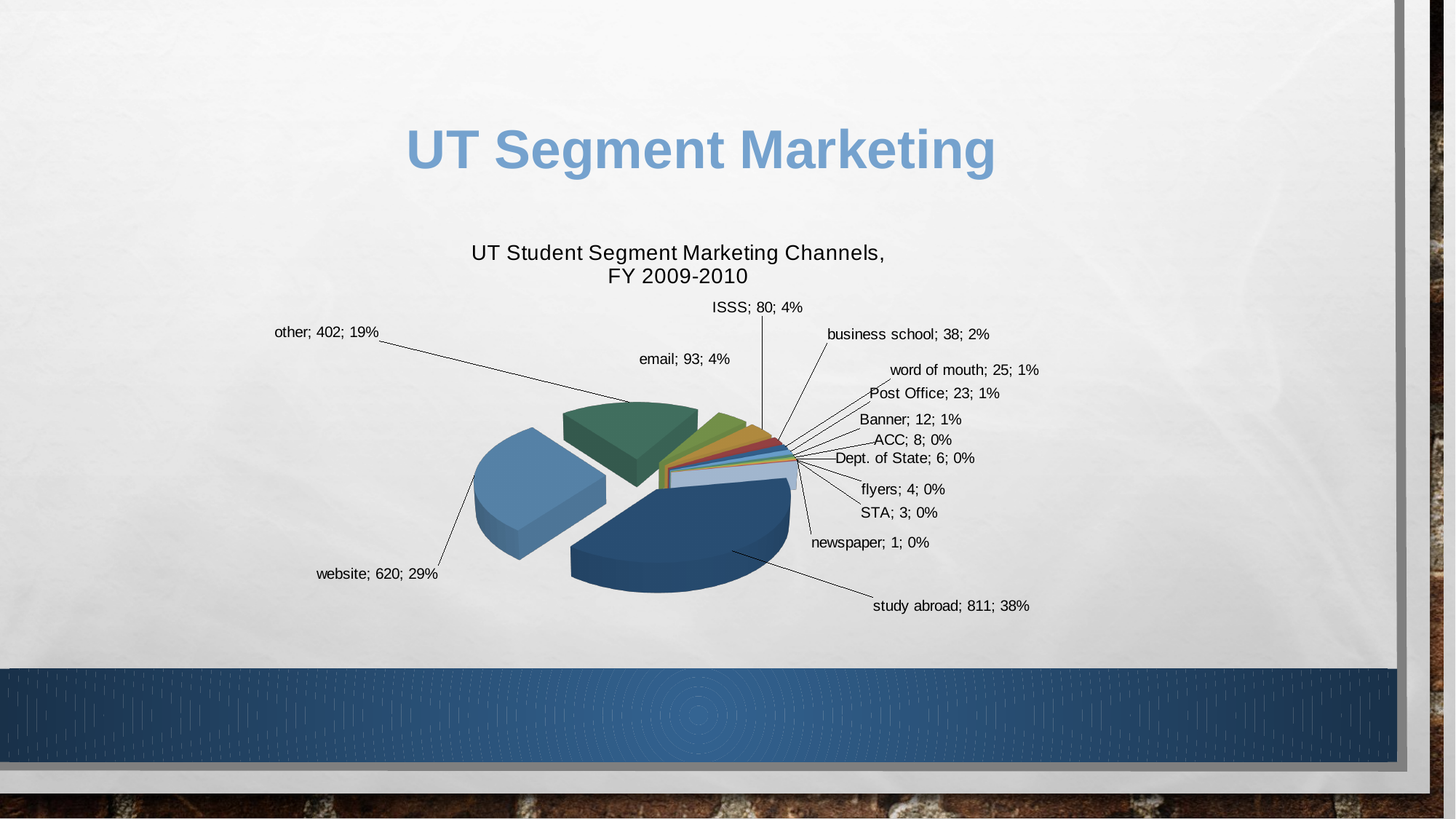
Which is larger, the value for email or the value for ISSS? email What share of the pie does website represent? 29% What is the value for website? 620 What kind of chart is shown on the slide? pie chart Which category has the largest slice? study abroad What share of the pie does the other category represent? 19% Which category has the smallest slice? newspaper What is the value for study abroad? 811 How many categories (slices) does the pie chart have? 14 What is the value for ISSS? 80 What is the title of the chart? UT Student Segment Marketing Channels, FY 2009-2010 What is the difference between the values for study abroad and website? 191